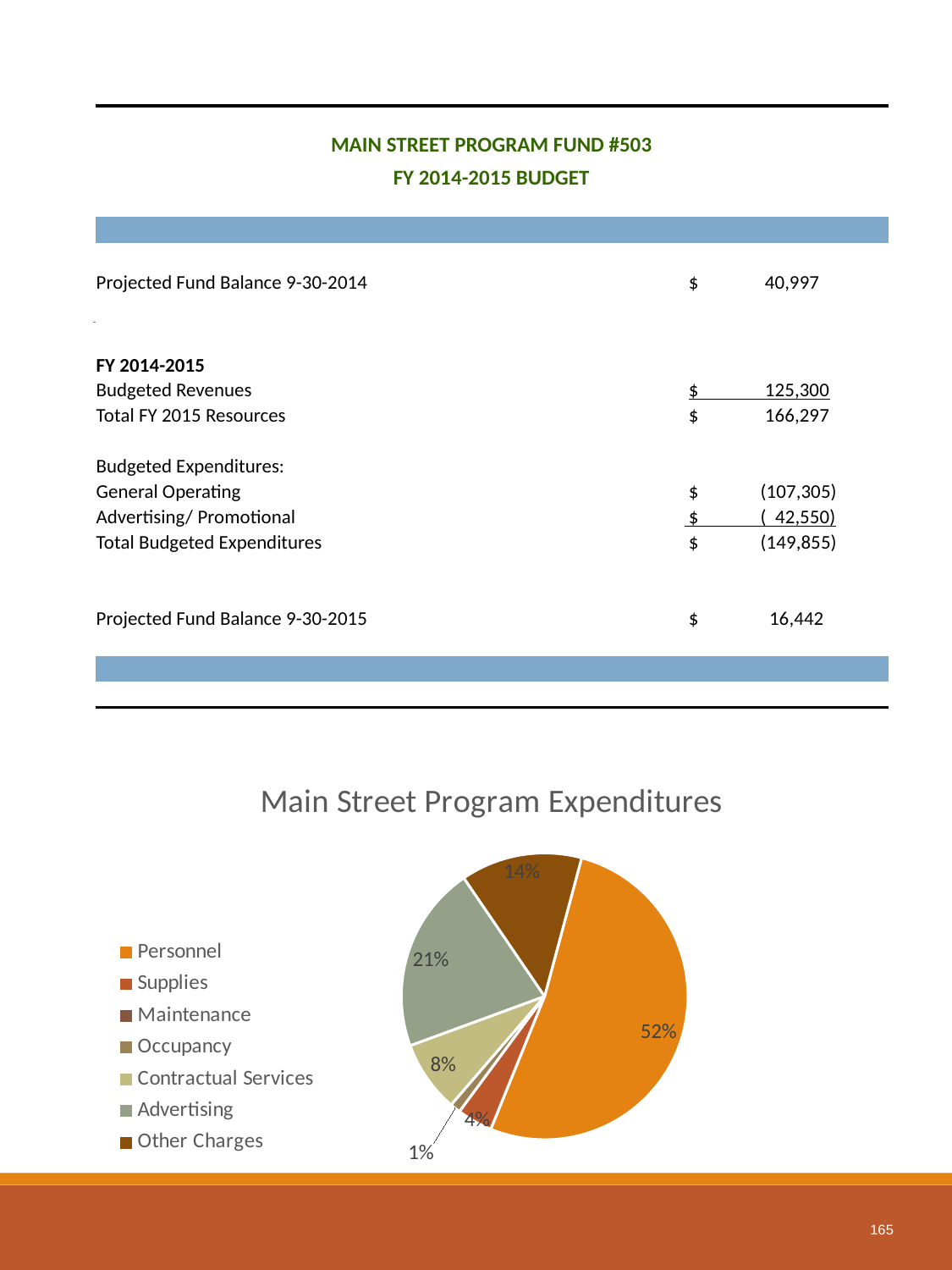
In the Main Street Program Expenditures pie chart, what percentage is Other Charges? 14% In the Main Street Program Expenditures pie chart, what percentage is Advertising? 21% What kind of chart is shown under the title "Main Street Program Expenditures"? pie chart Which category has the largest slice in the Main Street Program Expenditures pie chart? Personnel In the Main Street Program Expenditures pie chart, what percentage is Contractual Services? 8% What is the title of the pie chart on the slide? Main Street Program Expenditures In the Main Street Program Expenditures pie chart, what percentage is Supplies? 4% In the Main Street Program Expenditures pie chart, how many percentage points larger is Personnel than Advertising? 31 percentage points How many categories does the legend of the Main Street Program Expenditures pie chart list? 7 In the Main Street Program Expenditures pie chart, which is larger, Advertising or Other Charges? Advertising In the Main Street Program Expenditures pie chart, what is the difference between Advertising and Other Charges? 7 percentage points In the Main Street Program Expenditures pie chart, what percentage is Personnel? 52%